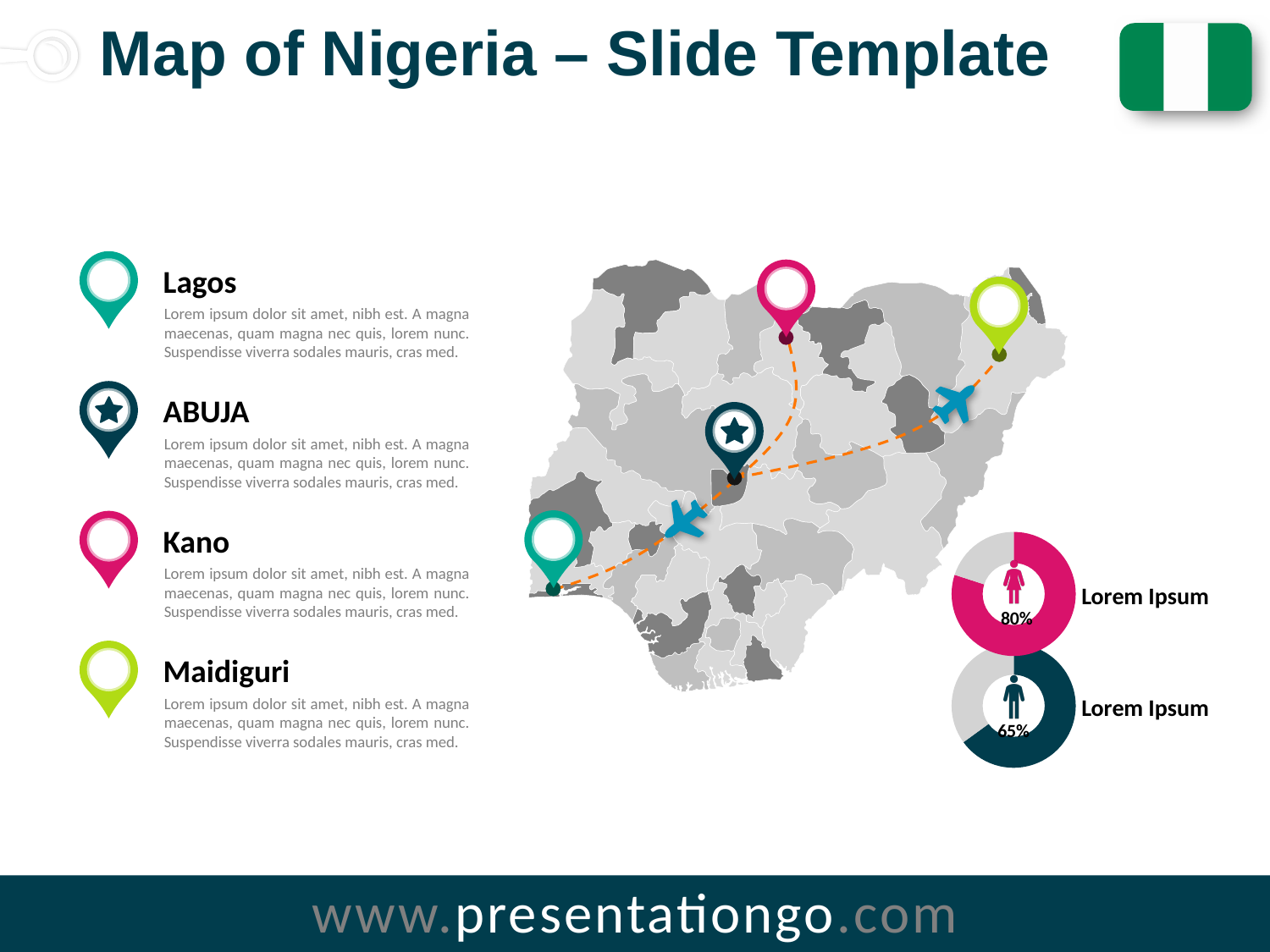
What percentage is shown on the lower (dark blue) donut chart with the male icon? 65% What kind of charts are shown at the bottom right of the map? Donut (pie) charts What share of the pink donut chart is filled by the coloured segment? 80% What is the difference between the percentages shown on the pink donut chart and the dark blue donut chart? 15 percentage points Which of the two donut charts shows the larger percentage, the pink one or the dark blue one? The pink one (80%) What label text appears next to each of the two donut charts? Lorem Ipsum What icon appears in the centre of the pink donut chart? A female (woman) figure How many donut charts are shown on the slide? 2 Is the value shown on the dark blue donut chart greater or less than 50%? greater What percentage is shown on the upper (pink) donut chart with the female icon? 80%